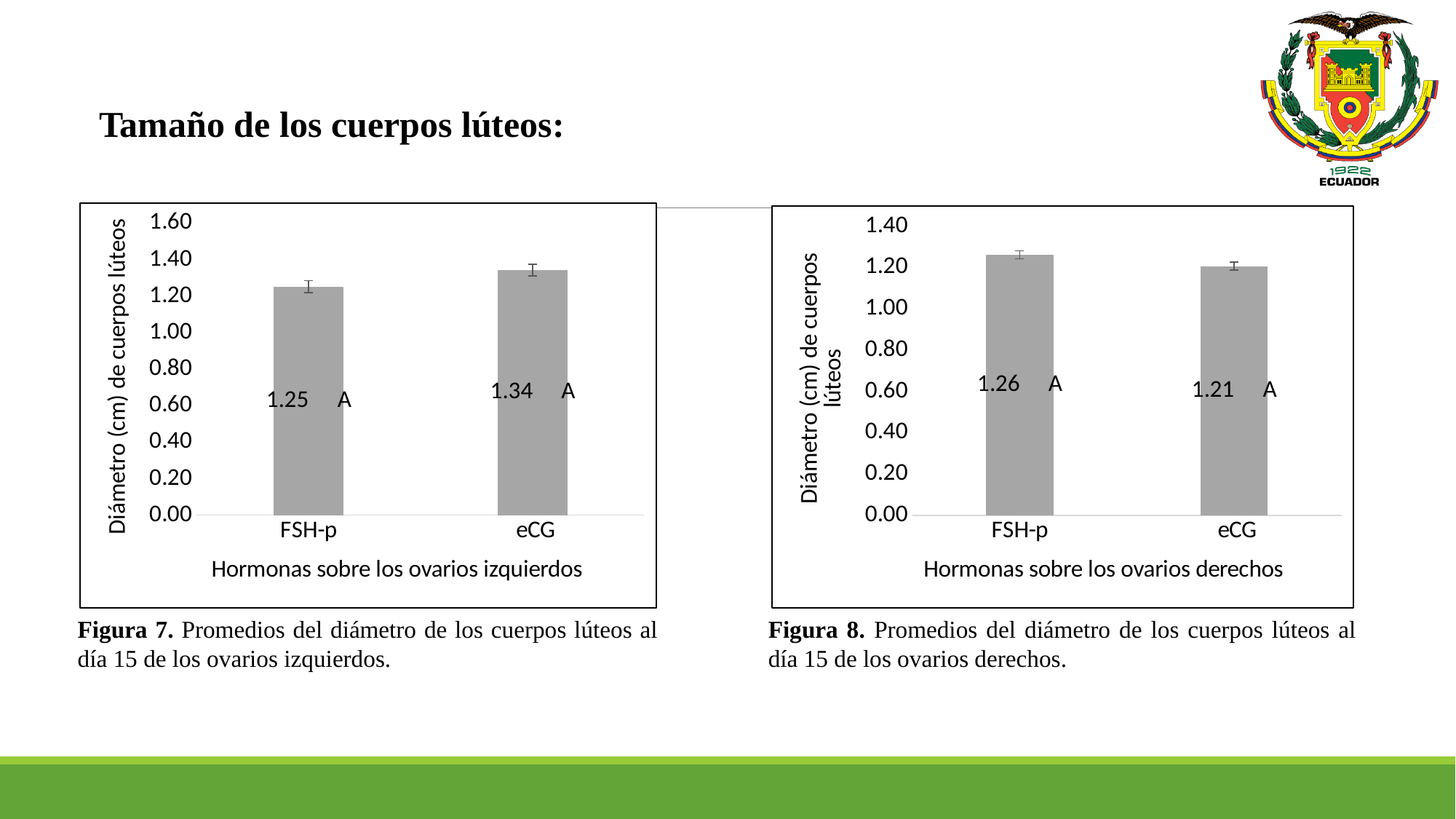
In the right chart (Hormonas sobre los ovarios derechos), what is the value for FSH-p? 1.26 What is the y-axis label of the left chart (Hormonas sobre los ovarios izquierdos)? Diámetro (cm) de cuerpos lúteos In the right chart (Hormonas sobre los ovarios derechos), is the value for FSH-p greater or less than 1.00? greater In the left chart (Hormonas sobre los ovarios izquierdos), what is the value for FSH-p? 1.25 In the right chart (Hormonas sobre los ovarios derechos), which hormone has the lower value? eCG In the right chart (Hormonas sobre los ovarios derechos), what is the value for eCG? 1.21 What kind of chart is the right chart (Hormonas sobre los ovarios derechos)? bar chart How many categories are shown on the x axis of the left chart (Hormonas sobre los ovarios izquierdos)? 2 In the right chart (Hormonas sobre los ovarios derechos), what is the difference between the FSH-p and eCG values? 0.05 In the left chart (Hormonas sobre los ovarios izquierdos), what is the value for eCG? 1.34 In the left chart (Hormonas sobre los ovarios izquierdos), what is the difference between the eCG and FSH-p values? 0.09 In the left chart (Hormonas sobre los ovarios izquierdos), which hormone has the higher value? eCG